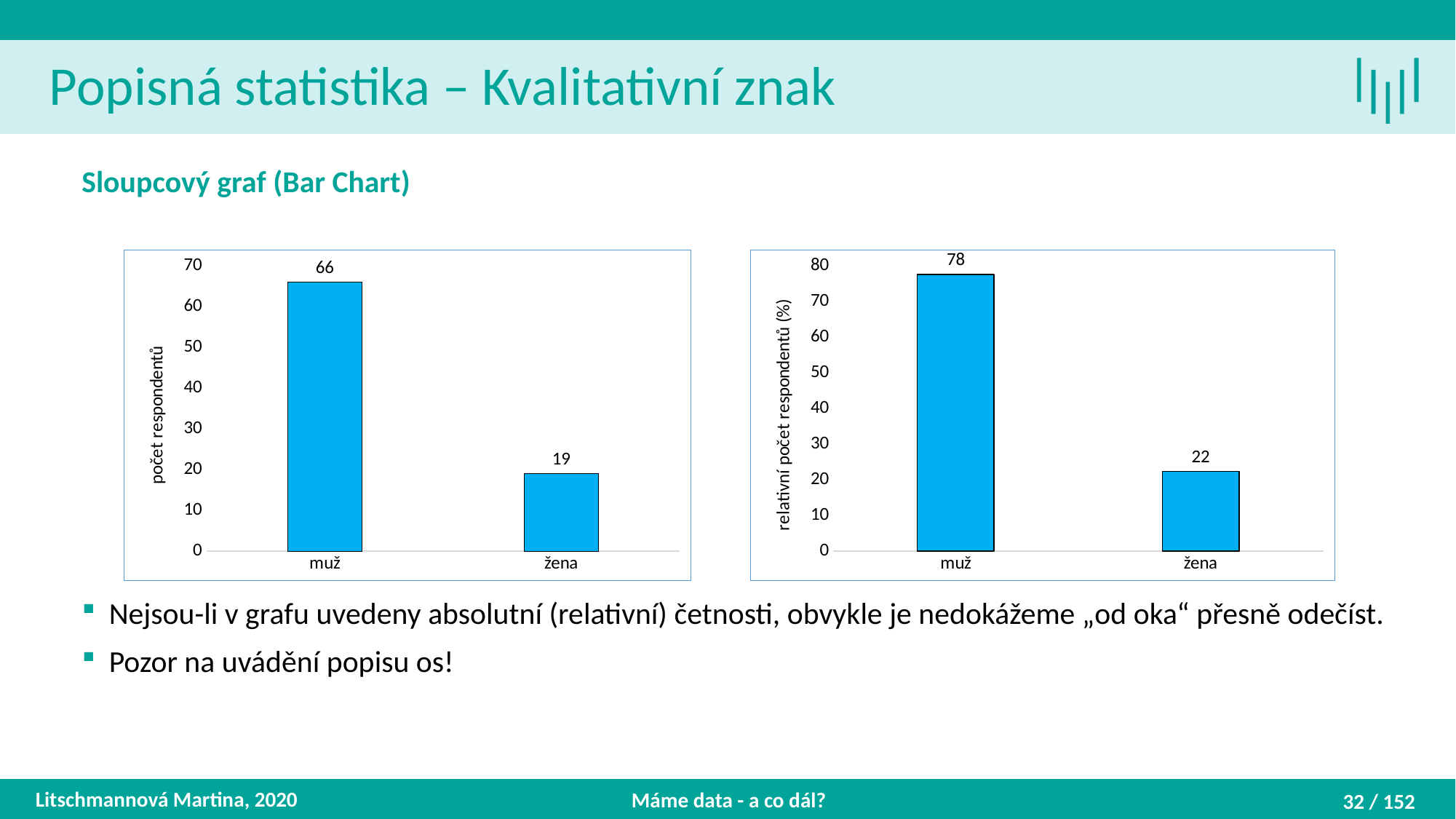
In the left chart (počet respondentů), which category has the highest value? muž In the right chart (relativní počet respondentů (%)), what is the difference between the values for muž and žena? 56 What kind of chart is the right chart (relativní počet respondentů (%))? bar chart In the right chart (relativní počet respondentů (%)), which is larger, the value for muž or for žena? muž In the left chart (počet respondentů), what is the value for muž? 66 In the right chart (relativní počet respondentů (%)), what is the value for žena? 22 How many categories are shown in the left chart (počet respondentů)? 2 In the right chart (relativní počet respondentů (%)), which category has the lowest value? žena What is the y-axis label of the left chart? počet respondentů In the left chart (počet respondentů), what is the difference between the values for muž and žena? 47 In the left chart (počet respondentů), what is the value for žena? 19 In the right chart (relativní počet respondentů (%)), what is the value for muž? 78